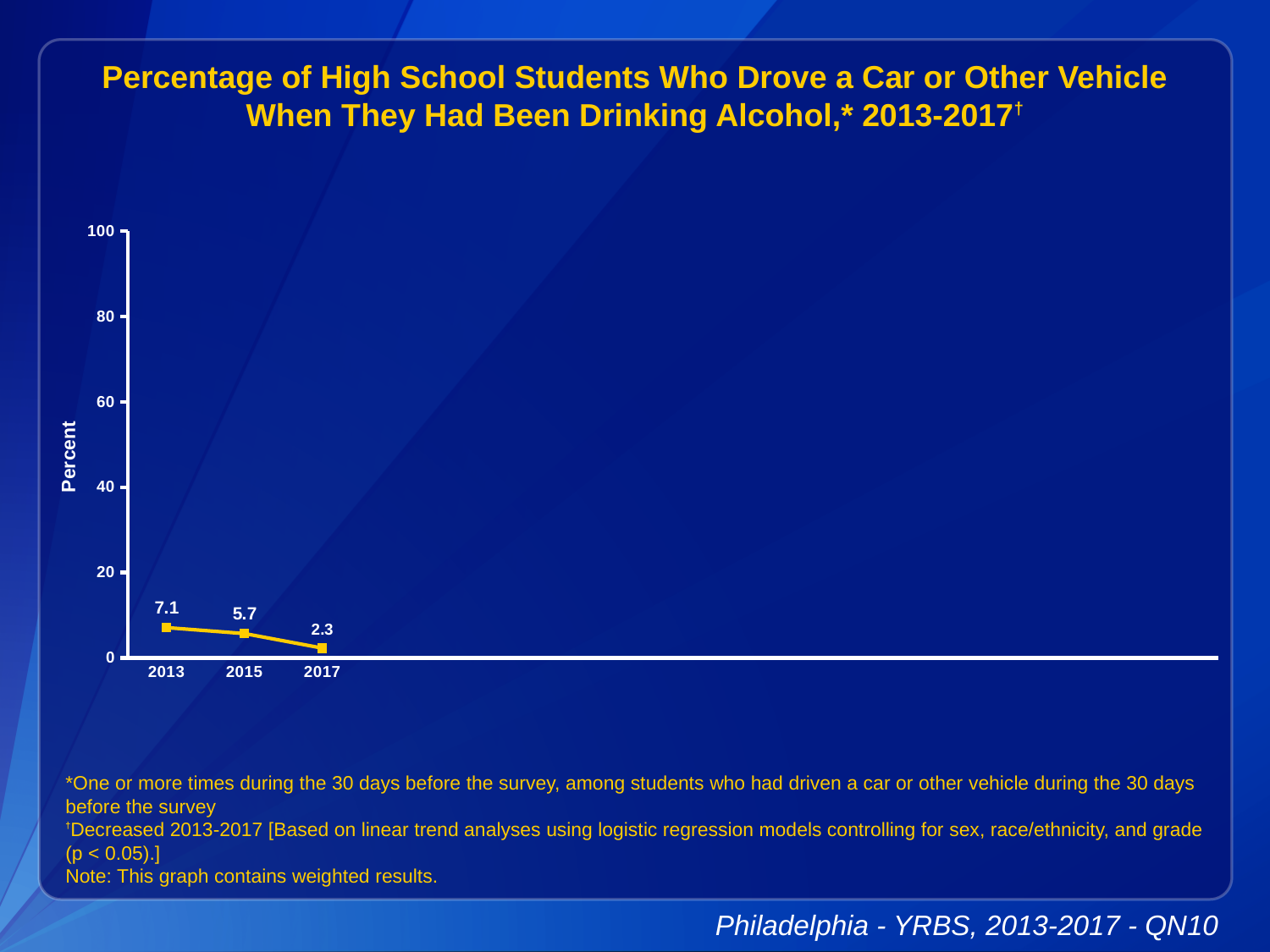
What kind of chart is shown on the slide? line chart What is the value for 2017? 2.3 What is the difference between the values for 2013 and 2017? 4.8 What is the difference between the values for 2013 and 2015? 1.4 Which year has the highest value? 2013 Which is larger, the value for 2015 or the value for 2017? 2015 What is the value for 2015? 5.7 What is the value for 2013? 7.1 Do the values rise or fall from 2013 to 2017? fall Which year has the lowest value? 2017 Is the value for 2013 greater or less than 20? less How many years are plotted on the chart? 3